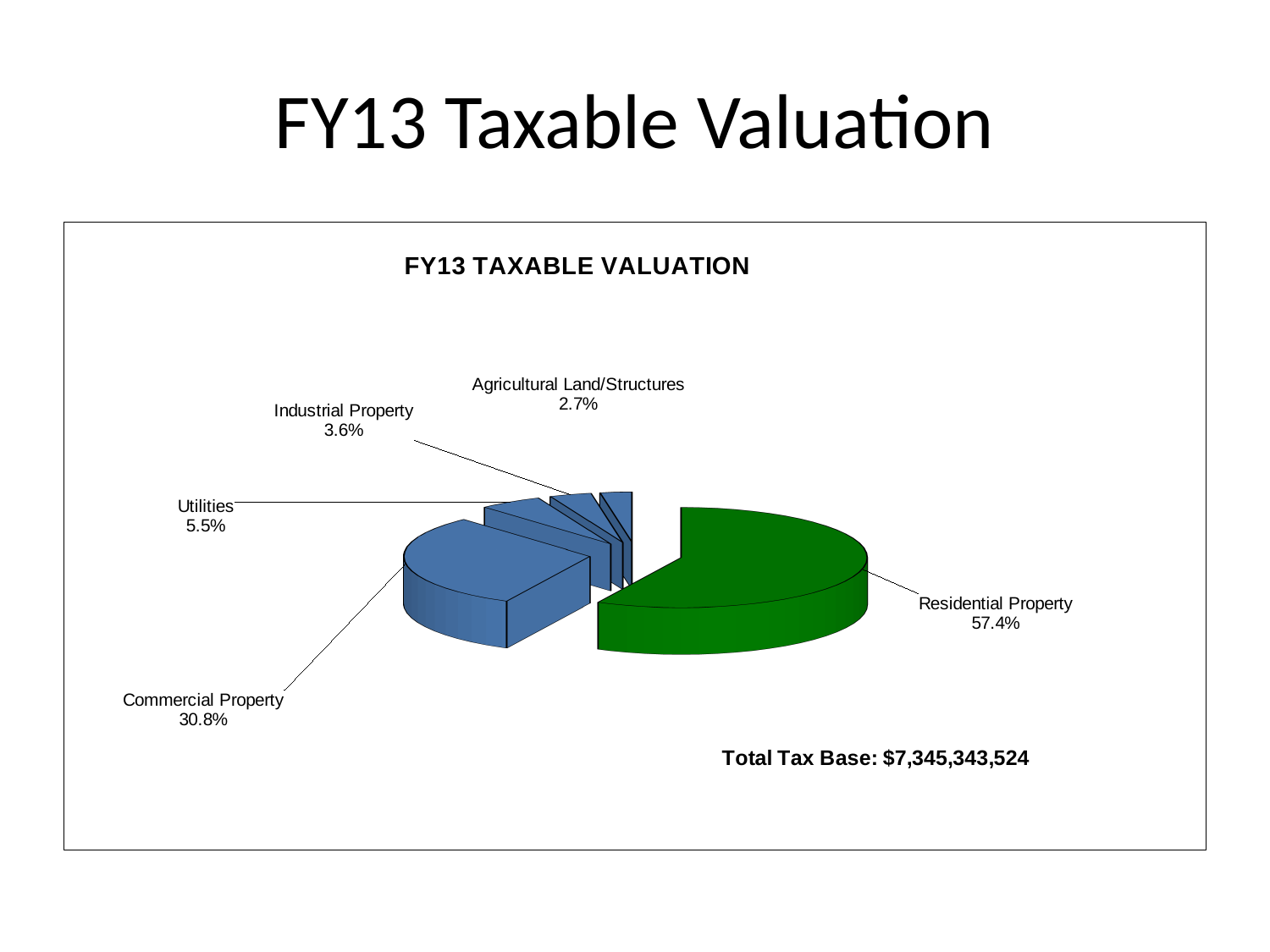
What kind of chart is shown on the slide? Pie chart Which category has the largest slice of the pie? Residential Property What is the difference in percentage points between Residential Property and Commercial Property? 26.6 What share of the FY13 taxable valuation is Commercial Property? 30.8% Which is larger, the share for Utilities or the share for Industrial Property? Utilities What percentage is shown for Utilities? 5.5% What percentage is shown for Industrial Property? 3.6% How many categories are shown in the pie chart? 5 What total tax base is stated on the chart? $7,345,343,524 Which category has the smallest slice of the pie? Agricultural Land/Structures What share of the FY13 taxable valuation is Residential Property? 57.4% What percentage is shown for Agricultural Land/Structures? 2.7%